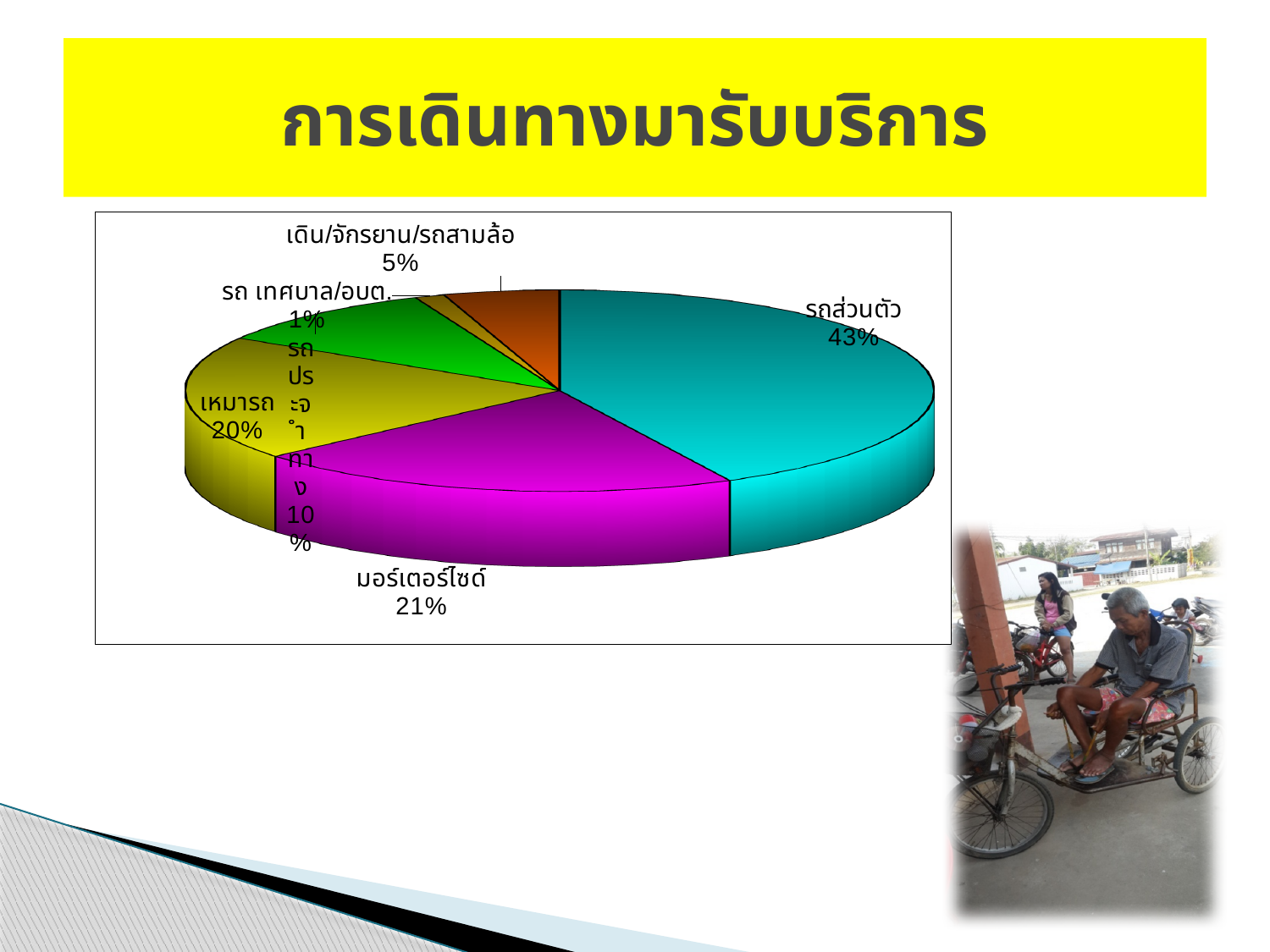
Which category has the largest share of the pie? รถส่วนตัว What is the title shown above the pie chart on the slide? การเดินทางมารับบริการ Which is larger, the share for เหมารถ or the share for รถประจำทาง? เหมารถ What is the difference in percentage points between รถส่วนตัว and มอร์เตอร์ไซด์? 22 Which category has the smallest share of the pie? รถ เทศบาล/อบต. What percentage of the pie is เหมารถ? 20% What percentage of the pie is รถส่วนตัว? 43% What percentage of the pie is รถ เทศบาล/อบต.? 1% What percentage of the pie is เดิน/จักรยาน/รถสามล้อ? 5% What kind of chart is shown on the slide? Pie chart What percentage of the pie is มอร์เตอร์ไซด์? 21% How many slices does the pie chart have? 6